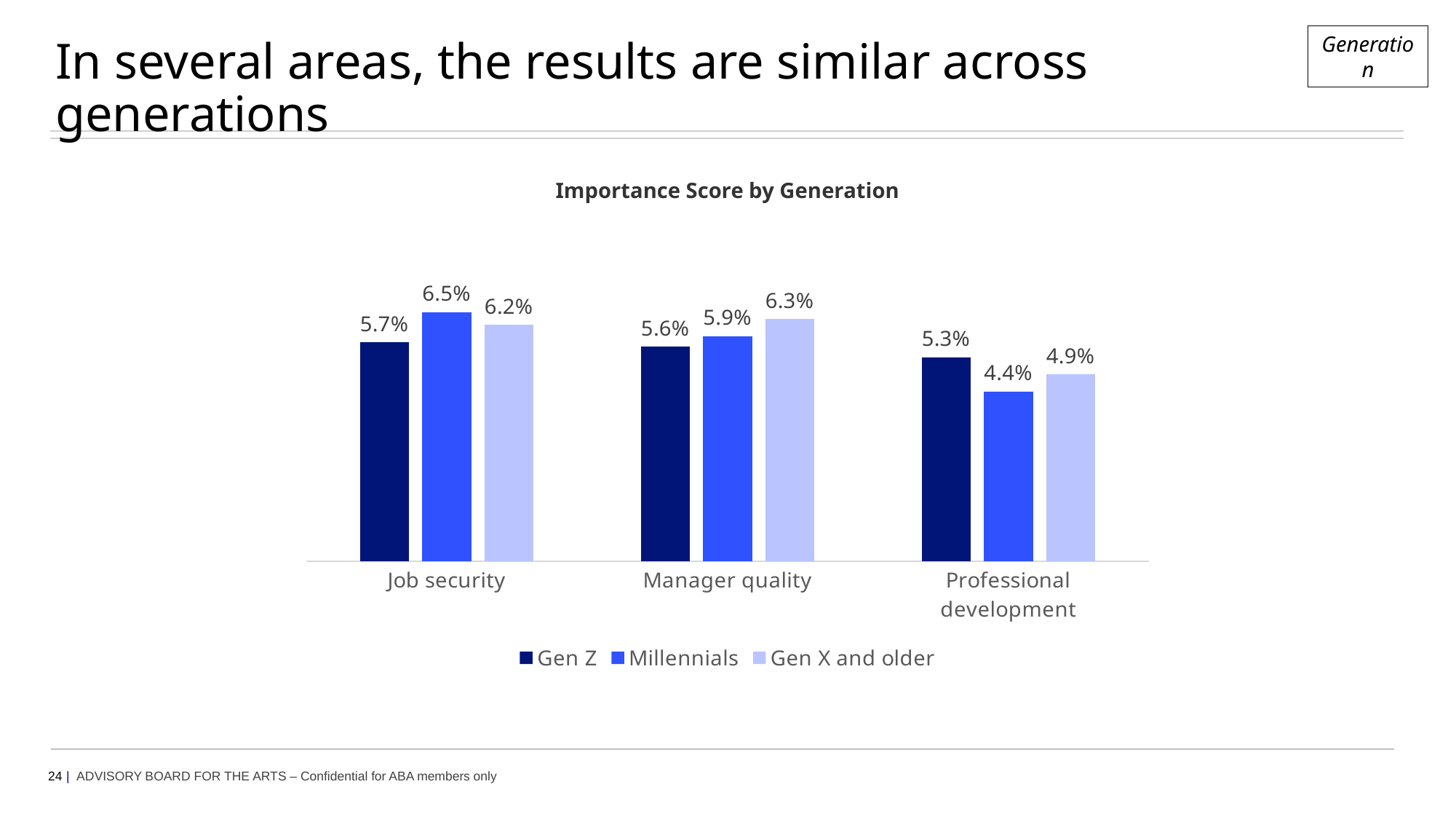
What is the title of the chart? Importance Score by Generation Which generation has the highest value for Job security? Millennials How many categories are shown on the x axis? 3 What is the Gen Z value for Job security? 5.7% Which generation has the lowest value for Professional development? Millennials What is the Millennials value for Professional development? 4.4% What is the difference between the Gen X and older and Millennials values for Professional development? 0.5% What is the difference between the Millennials and Gen Z values for Job security? 0.8% What is the Gen X and older value for Manager quality? 6.3% Which is larger for Manager quality: the Gen Z value or the Gen X and older value? Gen X and older How many series does the legend list? 3 What kind of chart is shown on the slide? Bar chart